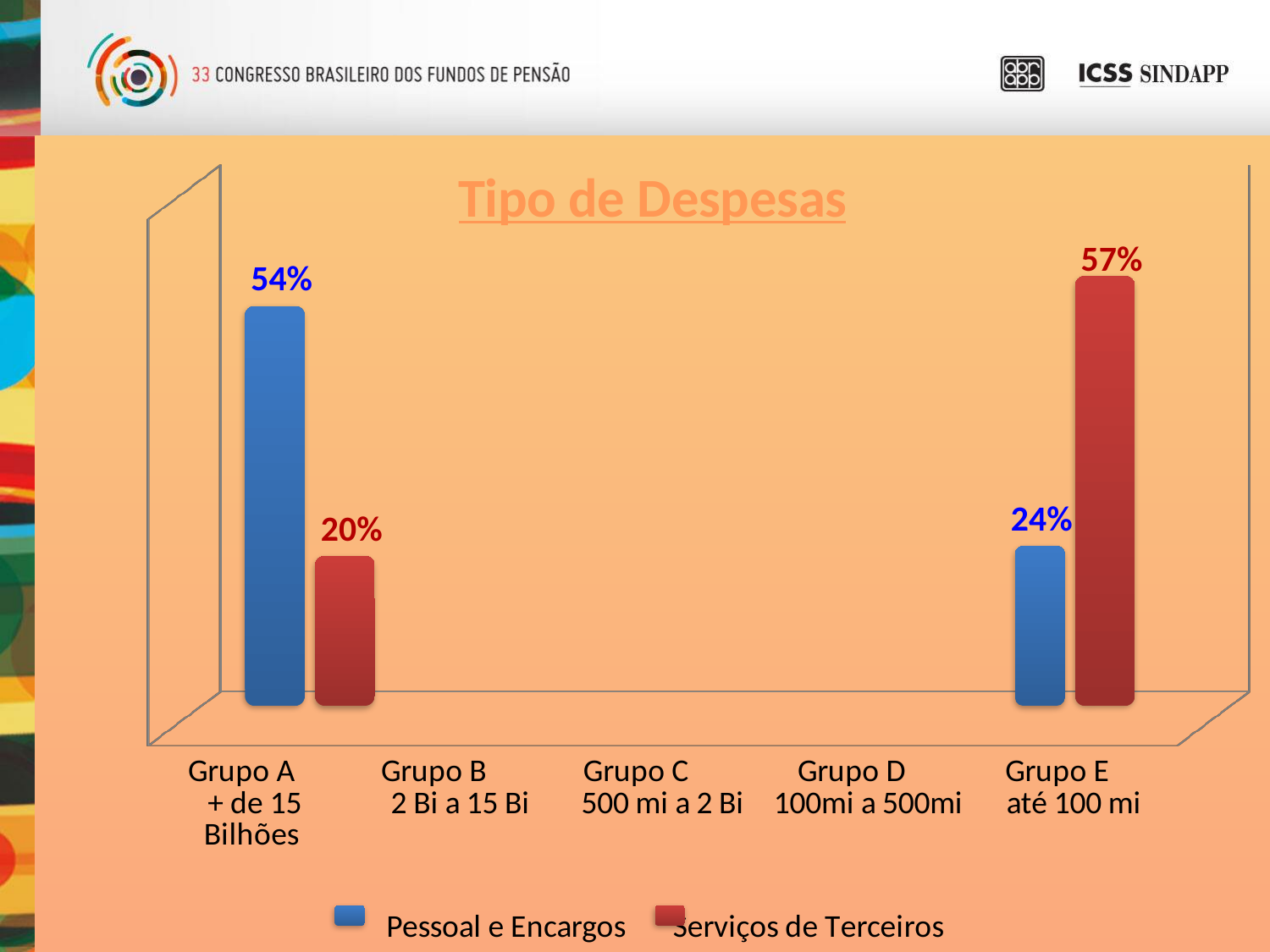
For Grupo E, which is larger: Pessoal e Encargos or Serviços de Terceiros? Serviços de Terceiros What is the value of Serviços de Terceiros for Grupo A? 20% How many series does the legend list? 2 What is the difference between Pessoal e Encargos and Serviços de Terceiros for Grupo A? 34% What is the value of Pessoal e Encargos for Grupo E? 24% What are the two series named in the legend? Pessoal e Encargos; Serviços de Terceiros What is the value of Pessoal e Encargos for Grupo A? 54% What kind of chart is shown on the slide? bar chart Which group has the highest value for Serviços de Terceiros? Grupo E How many categories are labelled on the x axis? 5 What is the value of Serviços de Terceiros for Grupo E? 57% What is the title of the chart? Tipo de Despesas